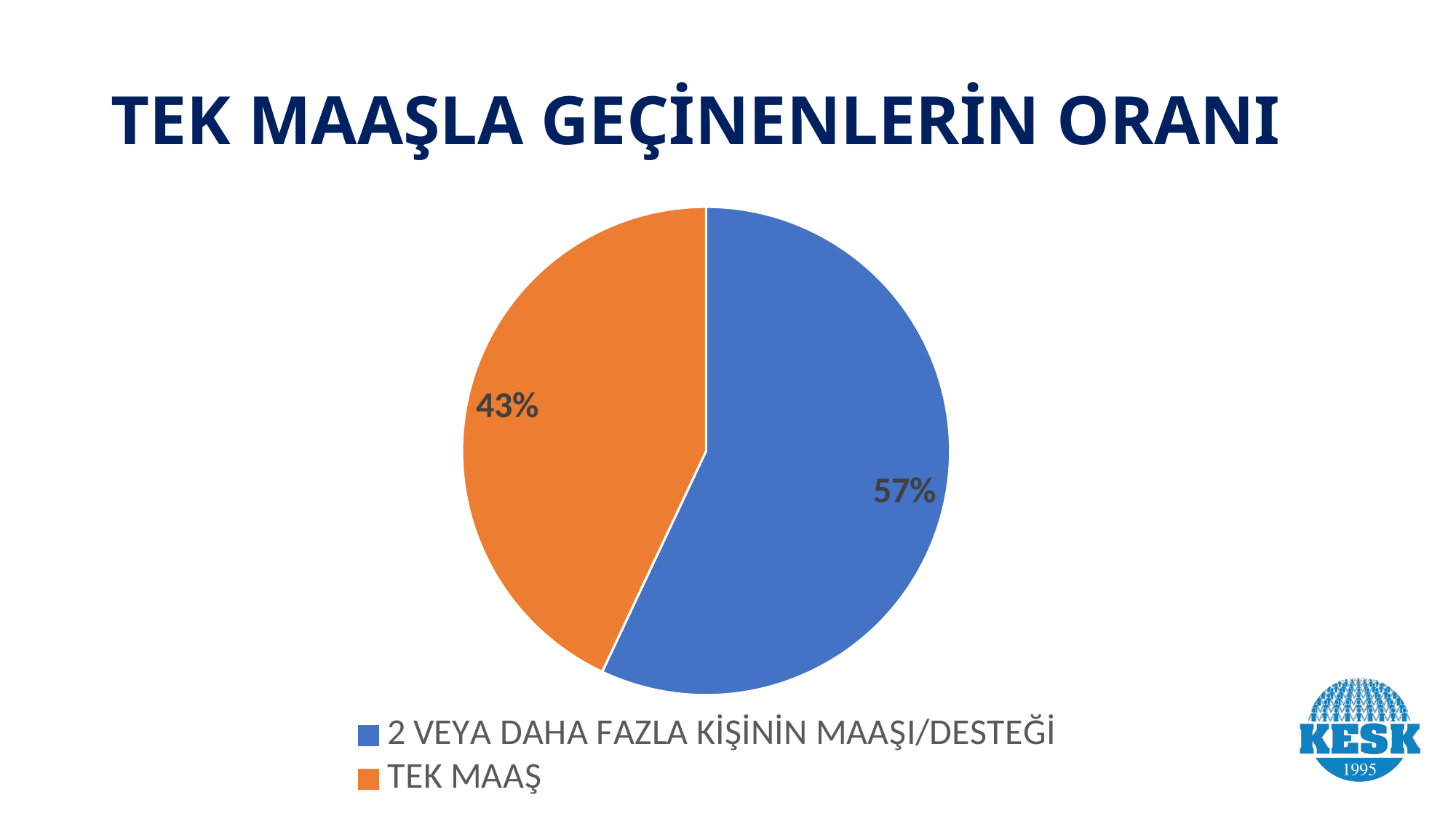
Which category has the largest share of the pie? 2 VEYA DAHA FAZLA KİŞİNİN MAAŞI/DESTEĞİ Which is larger, the share for TEK MAAŞ or the share for 2 VEYA DAHA FAZLA KİŞİNİN MAAŞI/DESTEĞİ? 2 VEYA DAHA FAZLA KİŞİNİN MAAŞI/DESTEĞİ What colour is the slice for TEK MAAŞ? orange What is the title of the slide? TEK MAAŞLA GEÇİNENLERİN ORANI What kind of chart is shown on the slide? pie chart What is the value for TEK MAAŞ? 43% Which category has the smallest share of the pie? TEK MAAŞ How many slices does the pie chart have? 2 How many entries does the legend list? 2 What is the value for 2 VEYA DAHA FAZLA KİŞİNİN MAAŞI/DESTEĞİ? 57% What is the difference between the share for 2 VEYA DAHA FAZLA KİŞİNİN MAAŞI/DESTEĞİ and the share for TEK MAAŞ? 14%